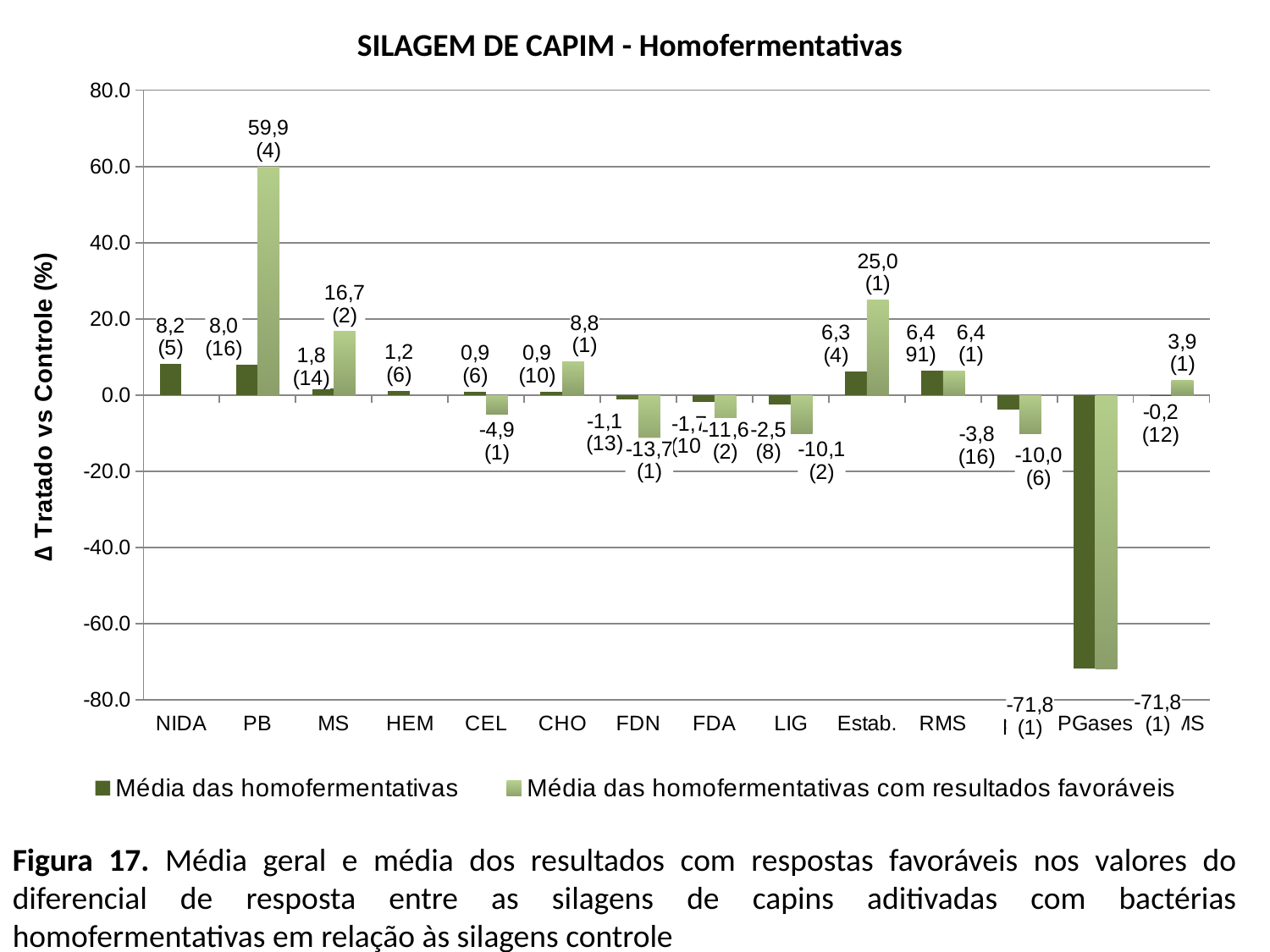
What kind of chart is shown on the slide? Bar chart What is the value of 'Média das homofermentativas com resultados favoráveis' for PB? 59,9 What is the value of 'Média das homofermentativas' for NIDA? 8,2 What is the difference between the two series' values for Estab.? 18,7 Which category has the lowest value for 'Média das homofermentativas'? PGases What is the difference between the two series' values for PB? 51,9 How many series does the legend list? 2 Which category has the highest value for 'Média das homofermentativas com resultados favoráveis'? PB Which is larger: the 'Média das homofermentativas com resultados favoráveis' value for Estab. or for MS? Estab. What is the value of 'Média das homofermentativas' for LIG? -2,5 What is the value of 'Média das homofermentativas com resultados favoráveis' for Estab.? 25,0 Is the 'Média das homofermentativas com resultados favoráveis' value for PB greater or less than 40.0? greater